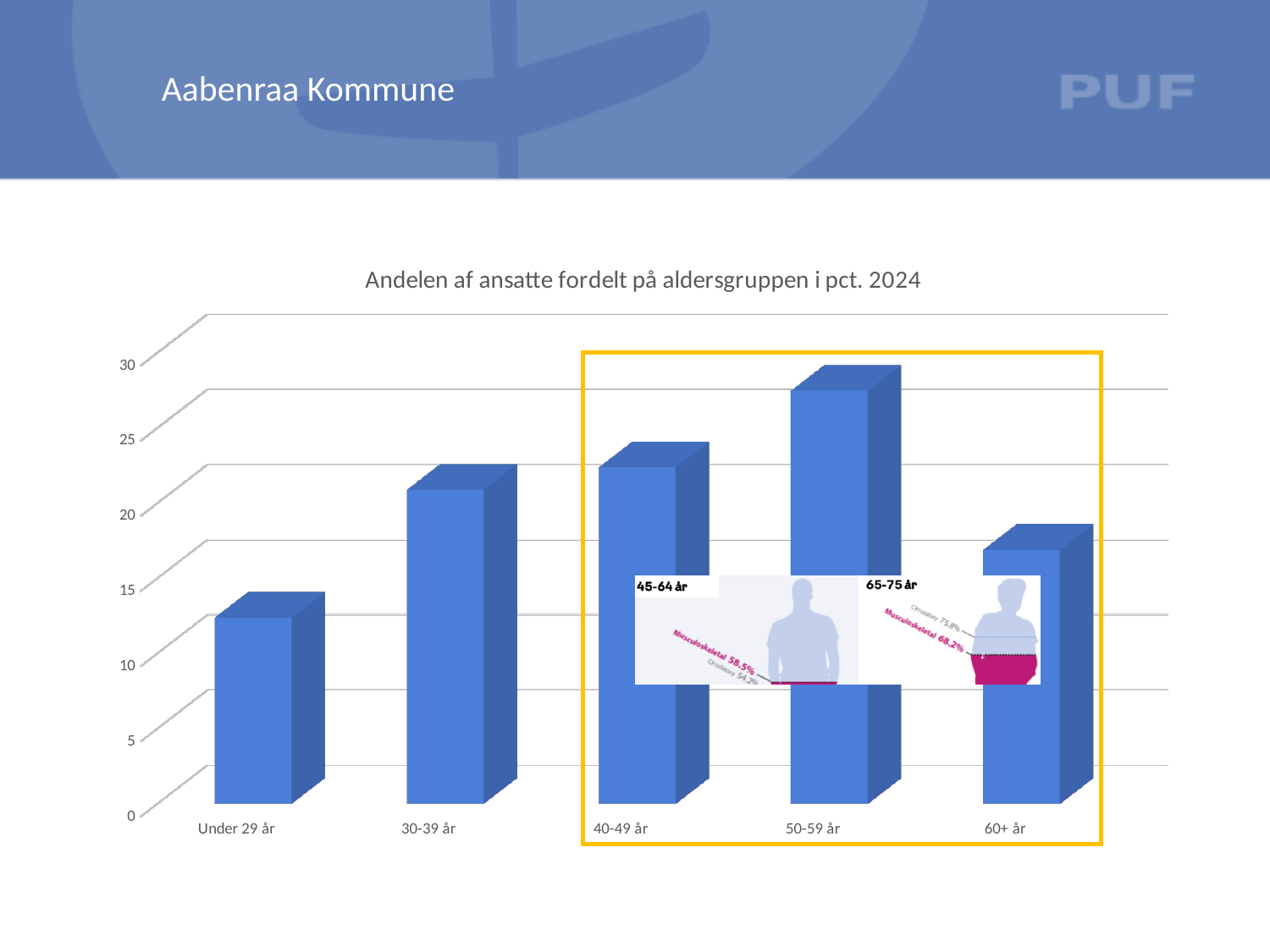
Do the values rise or fall from Under 29 år to 50-59 år? rise Is the value for 50-59 år greater or less than 25? greater Which age group has the highest share of employees? 50-59 år What is the title of the chart? Andelen af ansatte fordelt på aldersgruppen i pct. 2024 Which has a larger value, 50-59 år or 40-49 år? 50-59 år Is the value for Under 29 år greater or less than 15? less Which has a larger value, 30-39 år or 60+ år? 30-39 år How many age groups are shown on the x axis of the chart? 5 What kind of chart is shown on the slide? bar chart Which age group has the lowest share of employees? Under 29 år Is the value for 60+ år greater or less than 15? greater